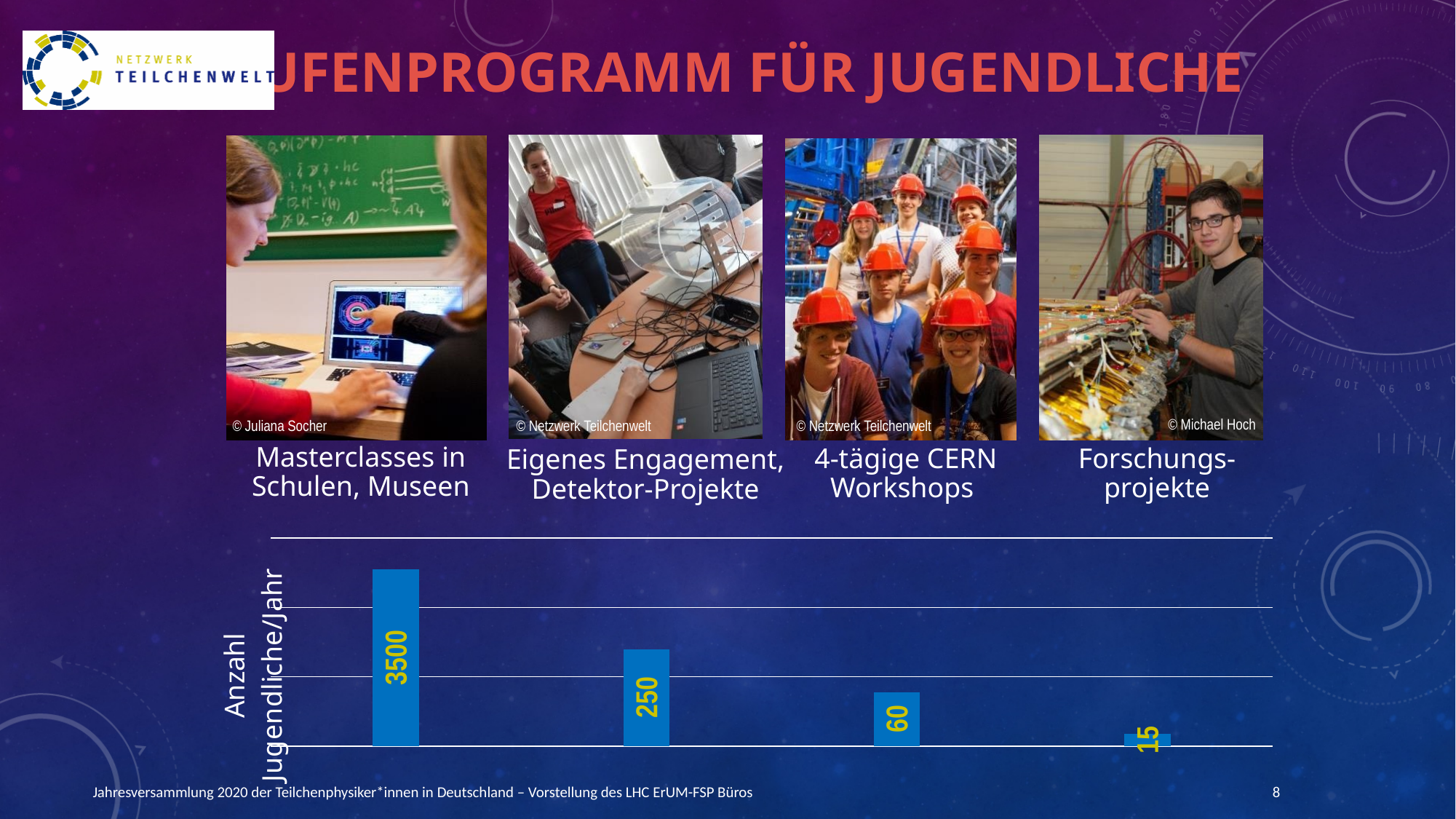
Which category has the lowest number of Jugendliche/Jahr? Forschungsprojekte What is the value shown for Forschungsprojekte? 15 What is the value shown for Eigenes Engagement, Detektor-Projekte? 250 What is the difference between the values for 4-tägige CERN Workshops and Forschungsprojekte? 45 Which is larger, the value for Eigenes Engagement, Detektor-Projekte or the value for 4-tägige CERN Workshops? Eigenes Engagement, Detektor-Projekte What is the label of the vertical axis of the chart? Anzahl Jugendliche/Jahr What is the value shown for Masterclasses in Schulen, Museen? 3500 Which category has the highest number of Jugendliche/Jahr? Masterclasses in Schulen, Museen What is the value shown for 4-tägige CERN Workshops? 60 What kind of chart is shown on the slide? Bar chart What is the difference between the values for Masterclasses in Schulen, Museen and Eigenes Engagement, Detektor-Projekte? 3250 How many bars does the chart show? 4